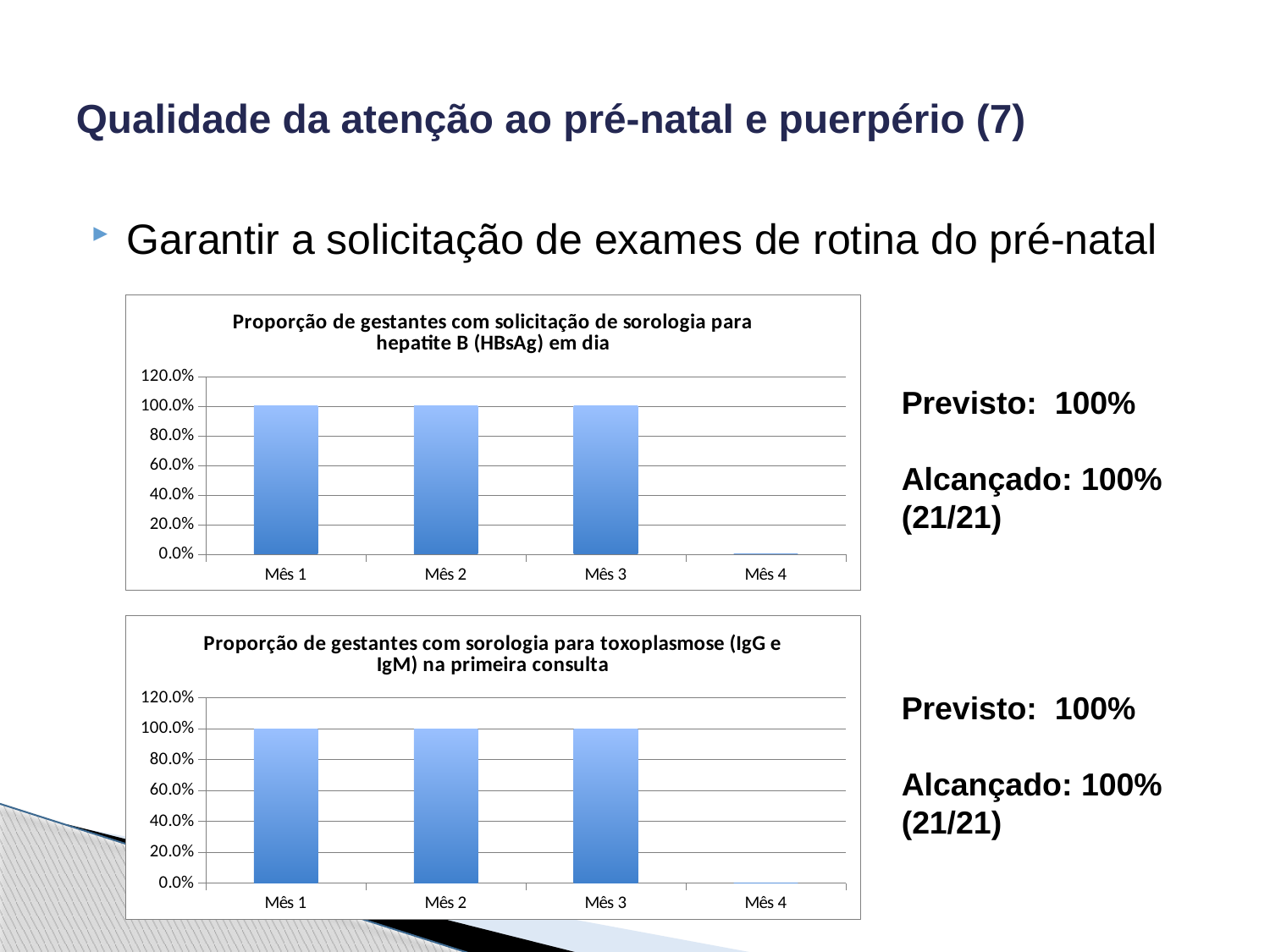
In the top chart (hepatite B), is the value for Mês 2 greater or less than 80.0%? greater In the top chart (hepatite B), which is larger, the value for Mês 3 or the value for Mês 4? Mês 3 In the top chart (hepatite B), which month has the lowest value? Mês 4 What kind of chart is the top chart (hepatite B)? Bar chart In the top chart (hepatite B), what is the value for Mês 1? 100.0% What is the title of the top chart? Proporção de gestantes com solicitação de sorologia para hepatite B (HBsAg) em dia In the bottom chart (toxoplasmose), is the value for Mês 4 greater or less than 20.0%? less In the bottom chart (toxoplasmose), what is the difference between the values for Mês 1 and Mês 2? 0.0% In the bottom chart (toxoplasmose), what is the value for Mês 3? 100.0% What is the highest value shown on the y axis of the bottom chart (toxoplasmose)? 120.0% In the bottom chart (toxoplasmose), which month has the lowest value? Mês 4 How many months are shown on the x axis of the bottom chart (toxoplasmose)? 4